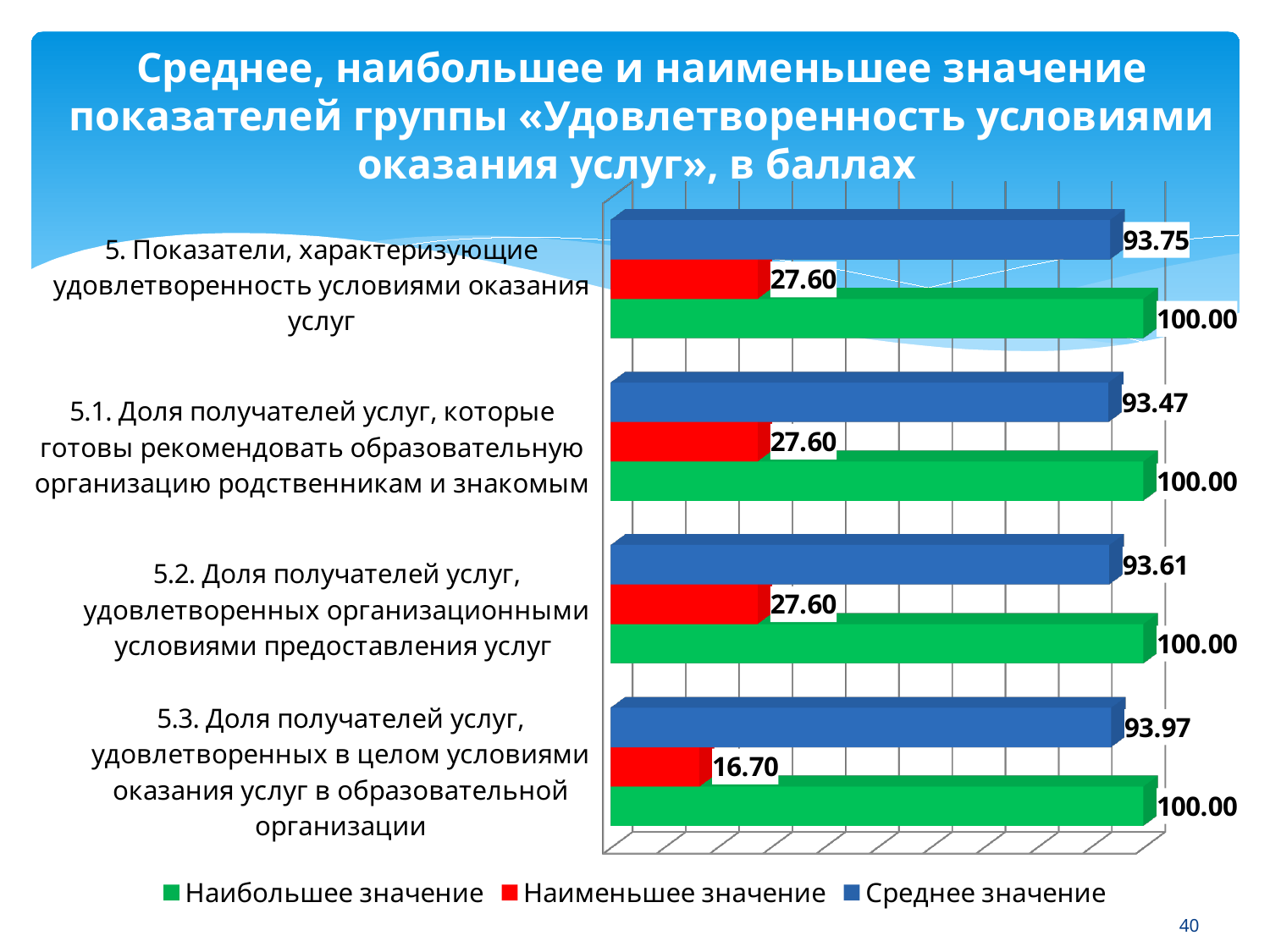
Which indicator has the highest Среднее значение? 5.3 Which is larger: the Наименьшее значение for indicator 5.2 or for indicator 5.3? 5.2 What is the Среднее значение for indicator 5.3? 93.97 How many series does the legend list? 3 What kind of chart is shown on the slide? Bar chart What is the Наименьшее значение for indicator 5.3? 16.70 Which indicator has the lowest Наименьшее значение? 5.3 What is the difference between the Наибольшее значение and the Наименьшее значение for indicator 5.3? 83.30 What is the Среднее значение for indicator 5.1? 93.47 What is the difference between the Среднее значение for indicator 5 and for indicator 5.1? 0.28 How many indicators (categories) are shown in the chart? 4 What is the Наибольшее значение for indicator 5.2? 100.00